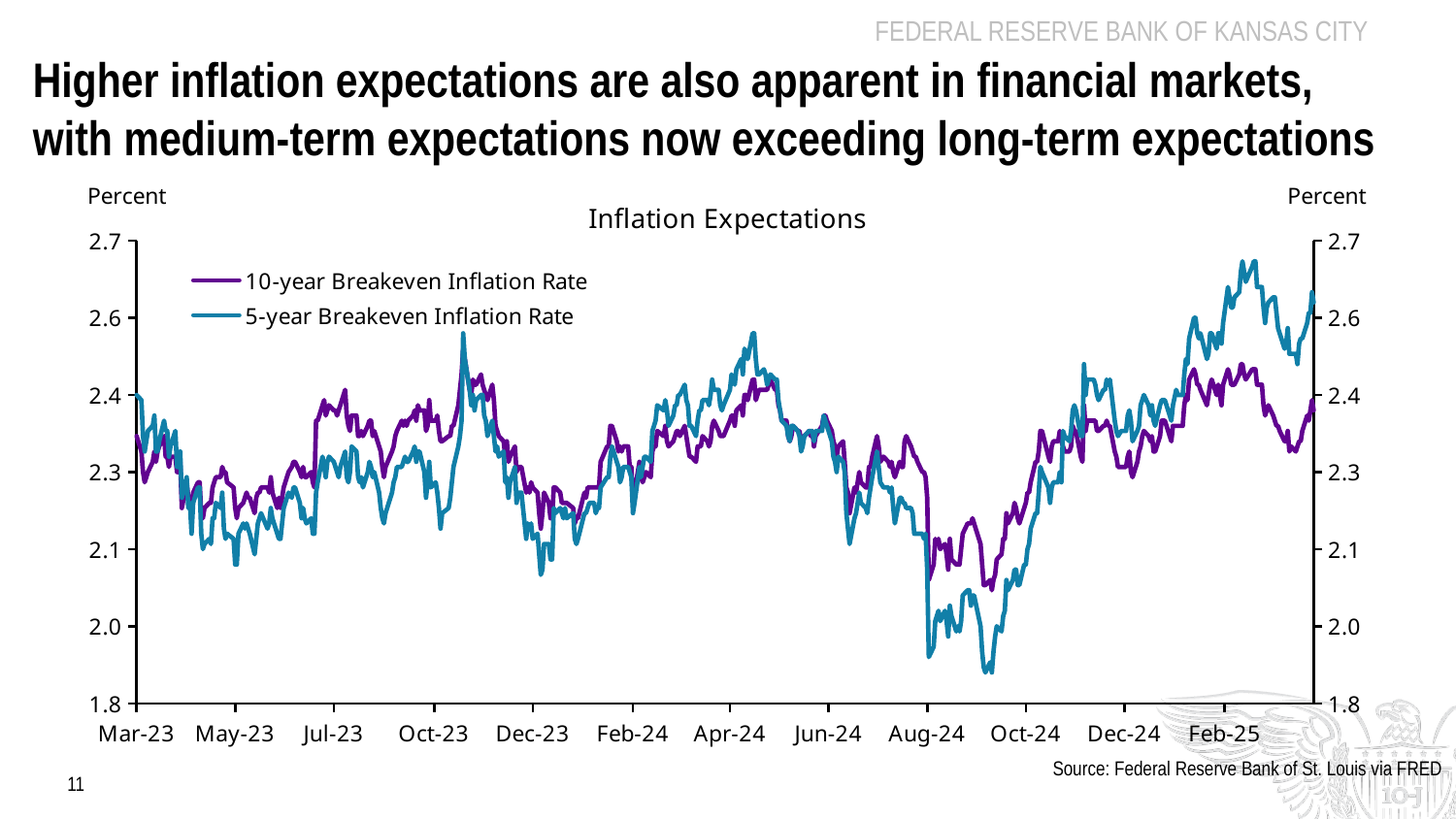
Do the breakeven inflation rates rise or fall between Oct-24 and Feb-25? rise Is the peak value of the 5-year Breakeven Inflation Rate in early 2025 greater or less than 2.6? greater Is the value of the 10-year Breakeven Inflation Rate in Feb-25 greater or less than 2.6? less How many series does the legend list? 2 Is the lowest value of the 5-year Breakeven Inflation Rate, around Sep-24, greater or less than 2.0? less How many month labels are shown on the x axis? 12 Which series reaches the highest value on the chart? 5-year Breakeven Inflation Rate What is the title of the chart? Inflation Expectations Which series reaches the lowest value on the chart? 5-year Breakeven Inflation Rate At the right end of the chart (Feb-25), which series is higher: the 5-year or the 10-year Breakeven Inflation Rate? 5-year Breakeven Inflation Rate What kind of chart is shown on the slide? Line chart What unit is shown on the vertical axis label? Percent